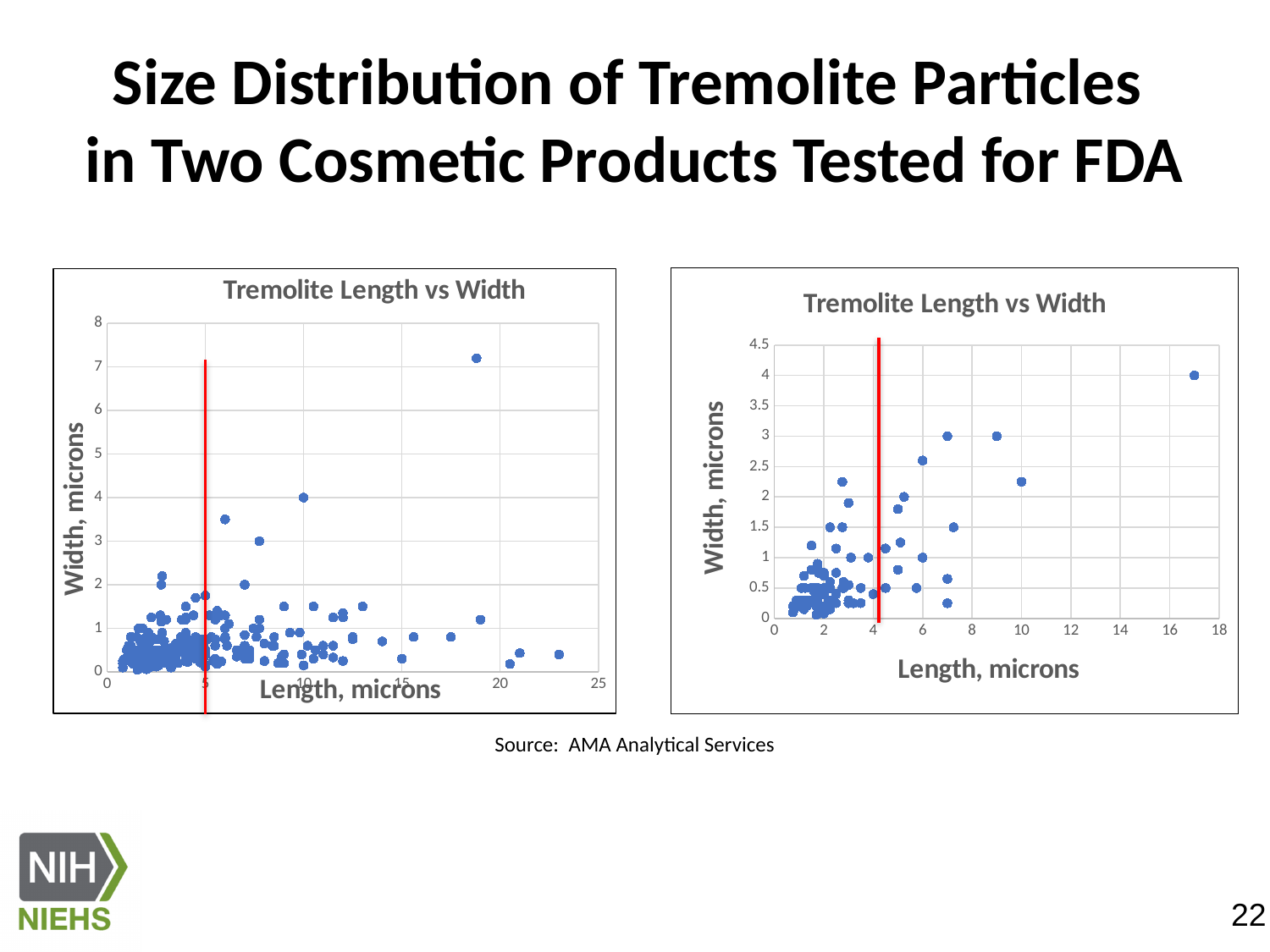
In the chart on the right, is the red vertical line at a length greater or less than 6 microns? less In the chart on the left, is the width of the widest particle greater or less than 6 microns? greater In the chart on the right, is the width of the particle with the greatest length greater or less than 3 microns? greater What is the title of the chart on the left of the slide? Tremolite Length vs Width What is the y-axis title of the chart on the right of the slide? Width, microns What kind of chart is the chart on the left of the slide? scatter chart Which chart has the higher maximum value on its y axis, the left chart or the right chart? the left chart What kind of chart is the chart on the right of the slide? scatter chart